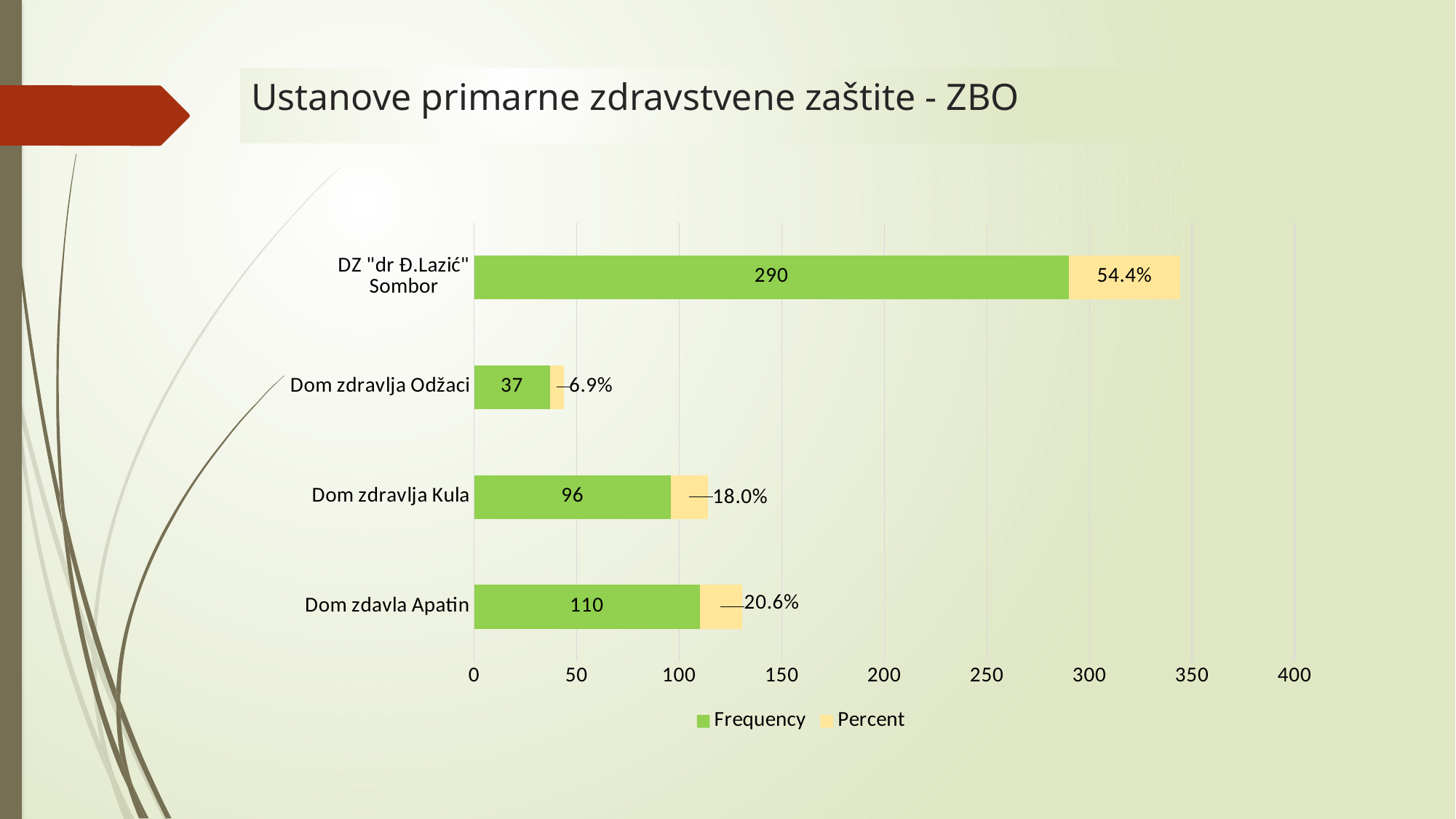
What is the Frequency value for Dom zdravlja Odžaci? 37 Which category has the highest Frequency? DZ "dr Đ.Lazić" Sombor How many categories are shown on the chart? 4 What is the Percent value for Dom zdravlja Kula? 18.0% How many series does the legend list? 2 What is the Frequency value for DZ "dr Đ.Lazić" Sombor? 290 Which category has the lowest Percent? Dom zdravlja Odžaci Which has a larger Frequency, Dom zdravlja Kula or Dom zdravlja Odžaci? Dom zdravlja Kula What is the Percent value for Dom zdavla Apatin? 20.6% What kind of chart is shown on the slide? Bar chart What is the title of the slide? Ustanove primarne zdravstvene zaštite - ZBO What is the difference in Frequency between Dom zdavla Apatin and Dom zdravlja Kula? 14